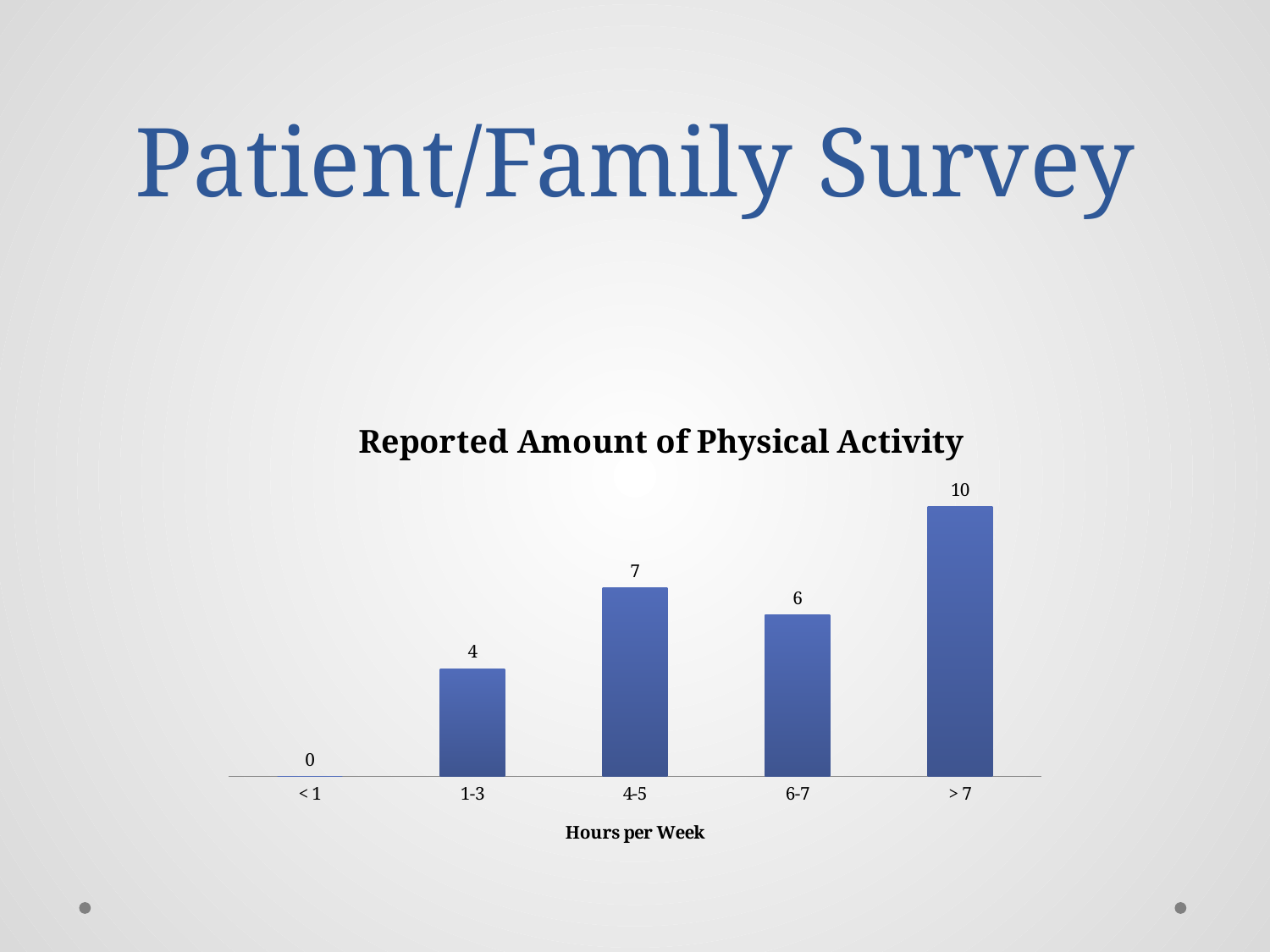
What is the difference between the values for "> 7" and "6-7"? 4 How many hours-per-week categories are shown on the x axis? 5 What is the value for the "> 7" hours per week category? 10 What is the value for the "1-3" hours per week category? 4 Which hours-per-week category has the lowest reported value? < 1 What kind of chart is shown on the slide? Bar chart What is the value for the "4-5" hours per week category? 7 What is the title of the chart? Reported Amount of Physical Activity Which is larger, the value for "4-5" or the value for "6-7"? 4-5 What is the label of the x axis? Hours per Week Which hours-per-week category has the highest reported value? > 7 What is the value for the "< 1" hours per week category? 0